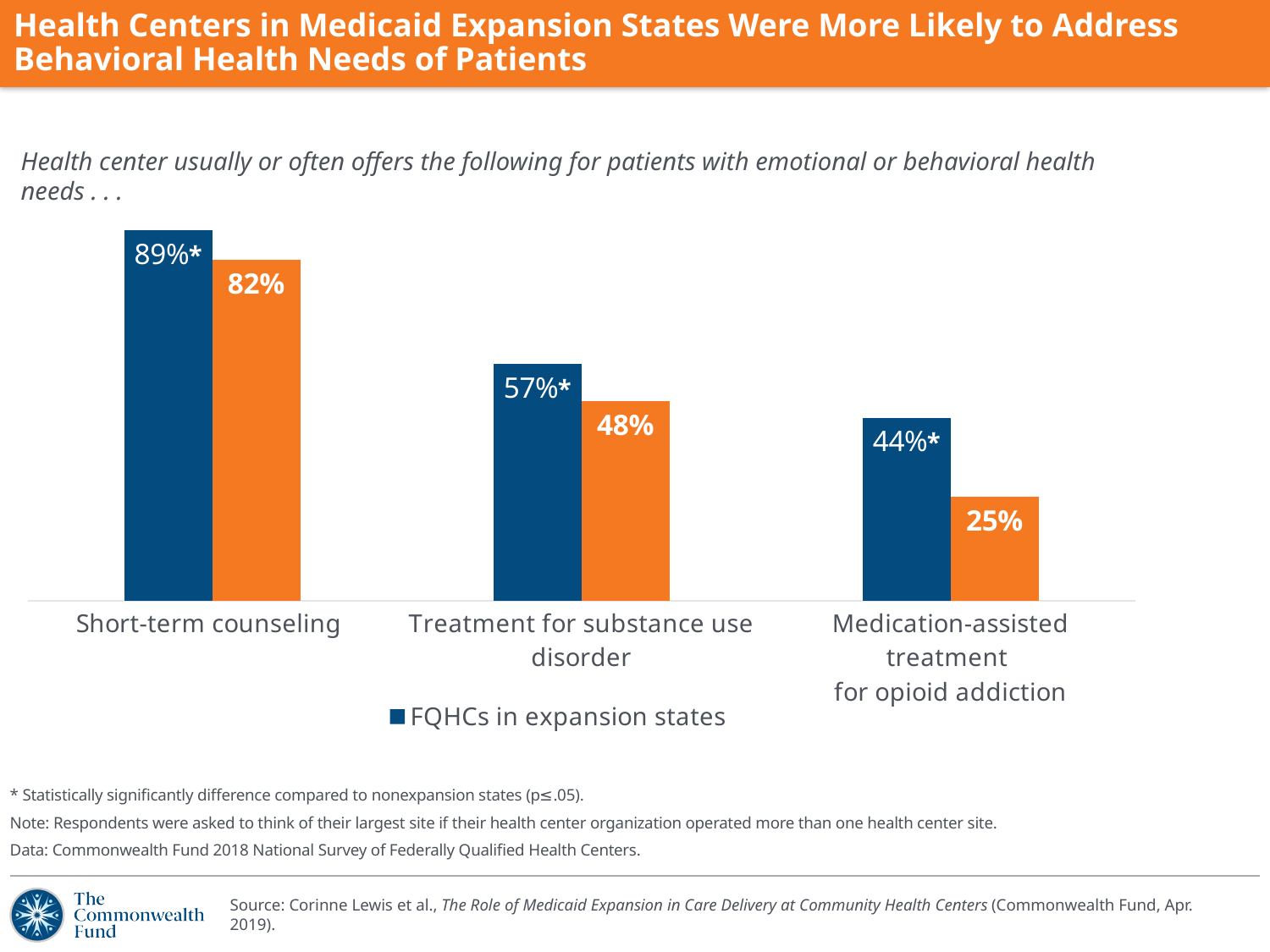
What is the value of the orange bar for Medication-assisted treatment for opioid addiction? 25% For Treatment for substance use disorder, which is larger: the blue bar or the orange bar? the blue bar What is the value for FQHCs in expansion states for Short-term counseling? 89% What kind of chart is shown on the slide? bar chart Which category has the lowest value for the orange bars? Medication-assisted treatment for opioid addiction What is the value of the orange bar for Treatment for substance use disorder? 48% How many categories are shown on the x axis? 3 What is the value for FQHCs in expansion states for Medication-assisted treatment for opioid addiction? 44% Which category has the highest value for FQHCs in expansion states? Short-term counseling What series name does the legend list? FQHCs in expansion states What is the difference between the blue and orange bars for Short-term counseling? 7 percentage points What is the difference between the blue and orange bars for Medication-assisted treatment for opioid addiction? 19 percentage points